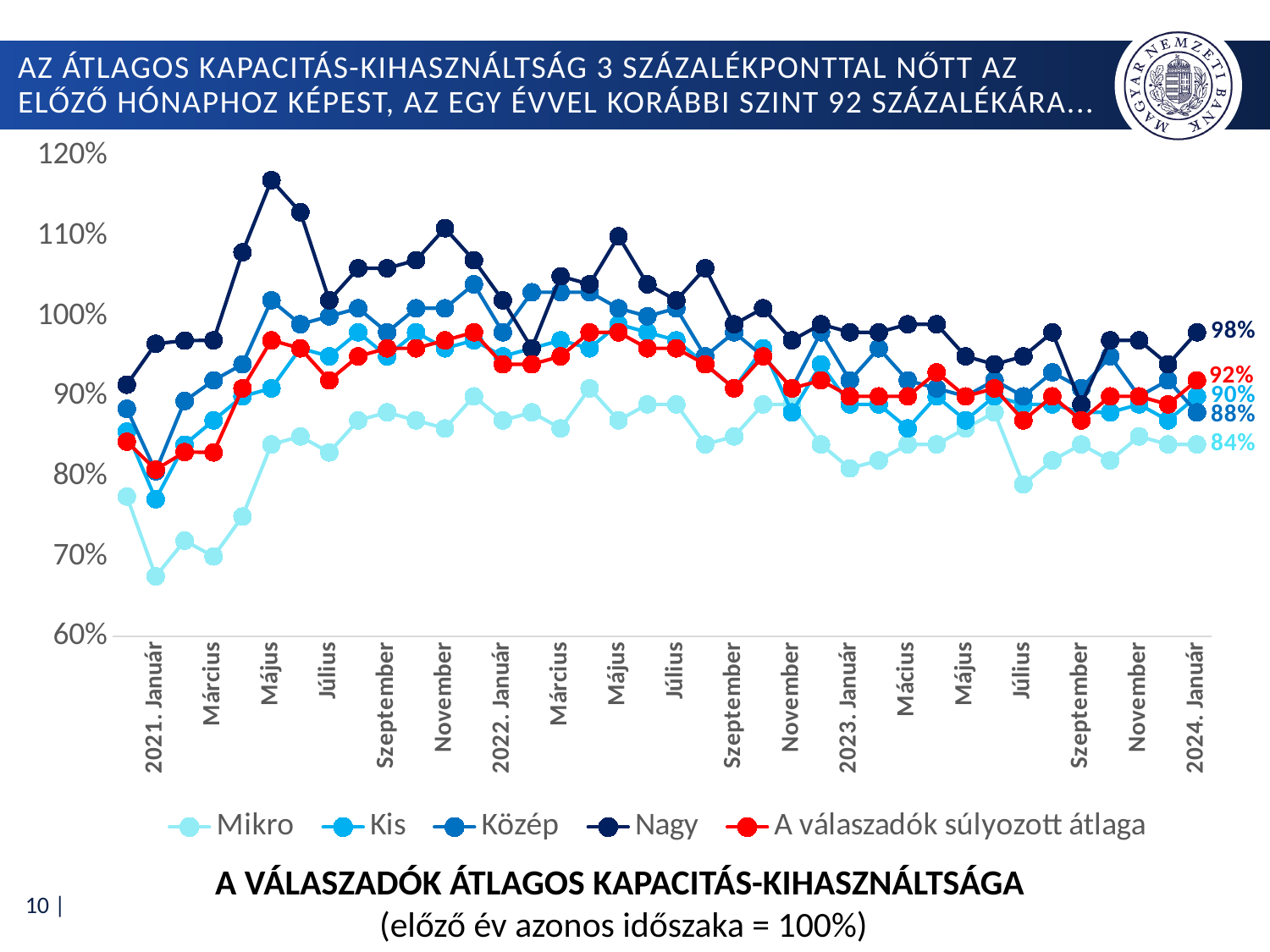
Which series is drawn in red? A válaszadók súlyozott átlaga What is the value of 'A válaszadók súlyozott átlaga' at 2024. Január? 92% What is the difference between the Nagy and Mikro values at 2024. Január? 14 percentage points What is the value of the Kis series at 2024. Január? 90% At 2024. Január, which is larger: the Kis value or the Közép value? Kis Which series has the highest value at 2024. Január? Nagy How many series does the legend list? 5 What kind of chart is shown on the slide? line chart Is the value of the Nagy series at Május 2021 greater or less than 110%? greater What is the value of the Nagy series at 2024. Január? 98% What is the value of the Mikro series at 2024. Január? 84% Which series has the lowest value at 2024. Január? Mikro